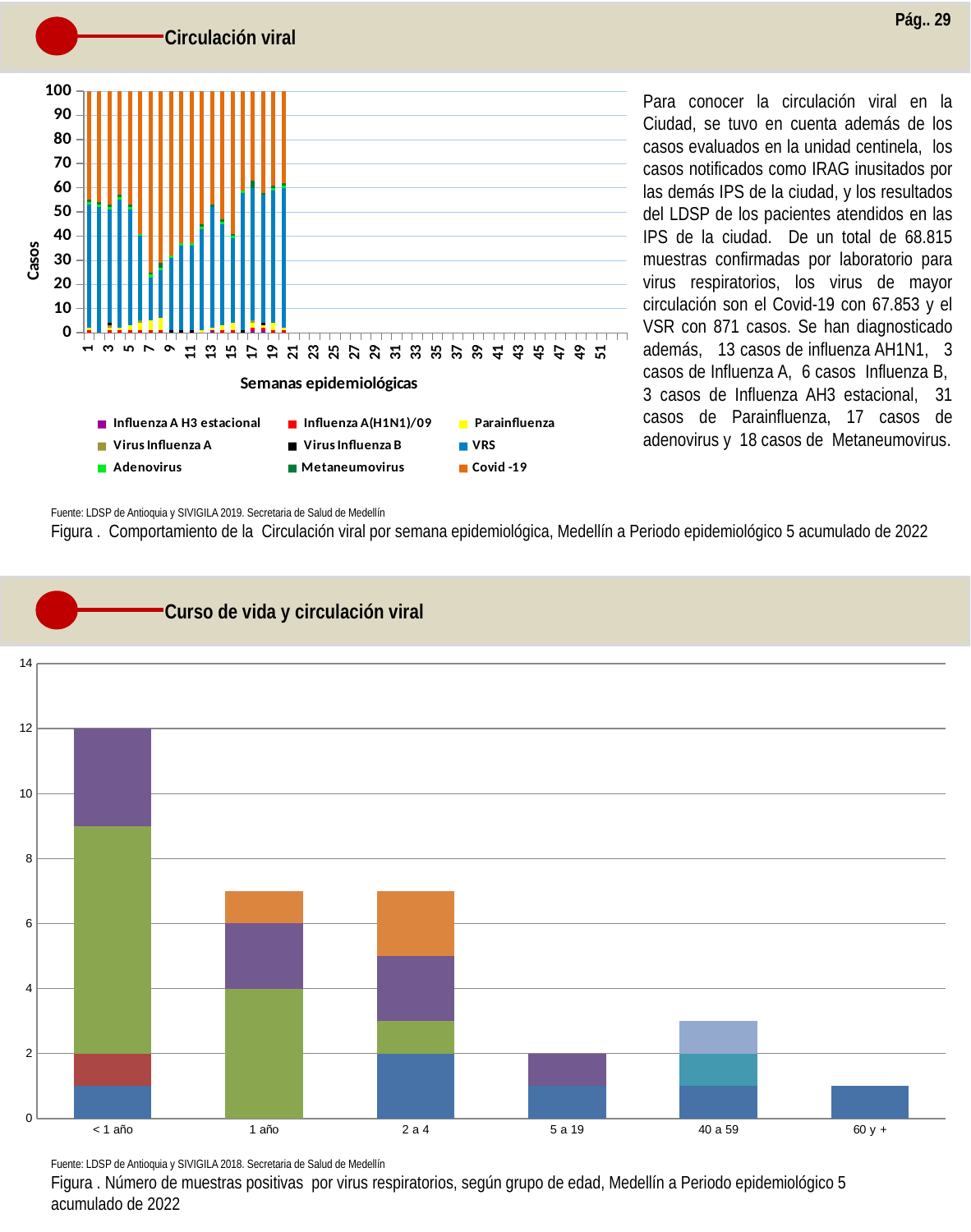
In the bottom chart (Curso de vida y circulación viral), which has the larger total: '40 a 59' or '5 a 19'? 40 a 59 In the bottom chart (Curso de vida y circulación viral), which age group has the tallest stacked bar? < 1 año In the top chart (Circulación viral), how many series does the legend list? 9 What kind of chart is the top chart titled 'Circulación viral'? Stacked bar chart In the top chart (Circulación viral), what is the title of the x axis? Semanas epidemiológicas In the bottom chart (Curso de vida y circulación viral), how many age groups are shown on the x axis? 6 In the bottom chart (Curso de vida y circulación viral), which age group has the shortest stacked bar? 60 y + In the bottom chart (Curso de vida y circulación viral), what is the total height of the stacked bar for '< 1 año'? 12 In the top chart (Circulación viral), what is the title of the y axis? Casos